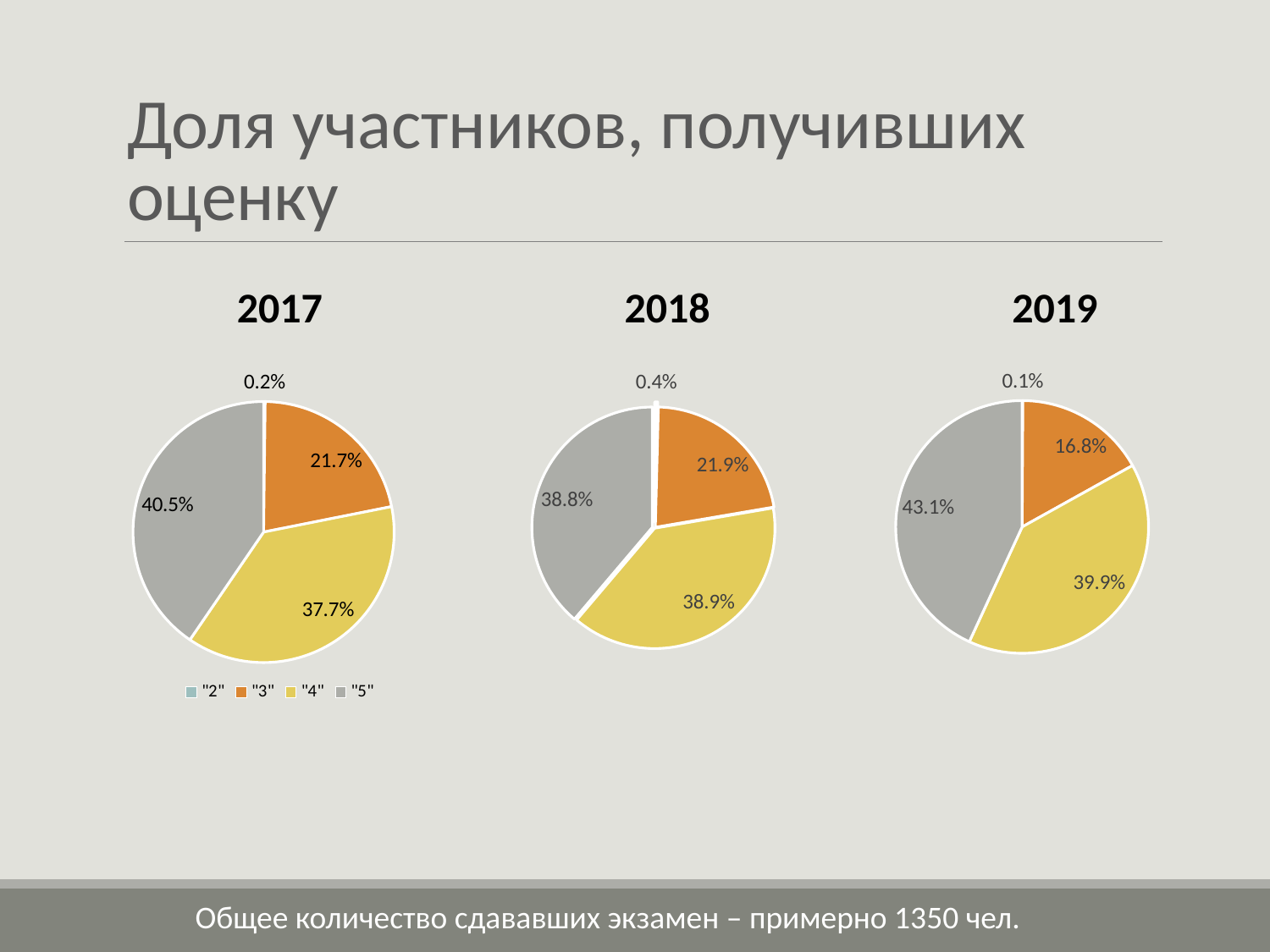
In the 2018 pie chart, what share of participants received a "3"? 21.9% In the 2019 pie chart, what share of participants received a "2"? 0.1% How many pie charts are shown on the slide? 3 In the 2019 pie chart, what share of participants received a "4"? 39.9% What type of chart is used for the 2018 data? Pie chart In the 2017 pie chart, what share of participants received a "5"? 40.5% In the 2017 pie chart, what is the difference between the share for "5" and the share for "4"? 2.8% In the 2019 pie chart, what is the difference between the share for "5" and the share for "3"? 26.3% How many entries does the legend list? 4 In the 2017 pie chart, which is larger: the share for "3" or the share for "4"? "4" In the 2019 pie chart, which grade has the largest share? "5" In the 2017 pie chart, which grade has the smallest share? "2"